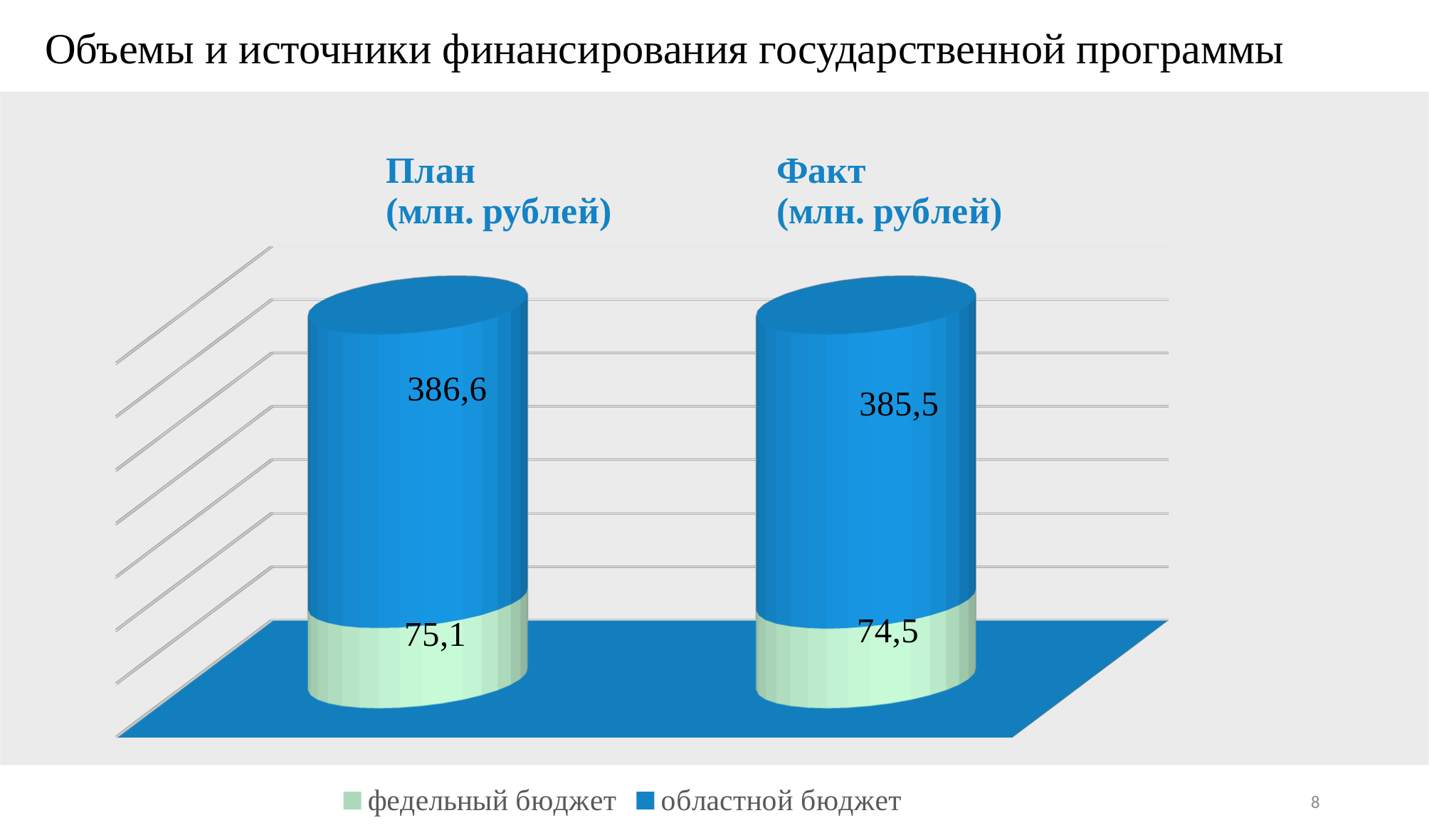
What is the total of the stacked bar for Факт? 460,0 How many series does the legend list? 2 What is the value of федельный бюджет for План? 75,1 Which is larger: областной бюджет for План or областной бюджет for Факт? План What is the total of the stacked bar for План? 461,7 What is the value of федельный бюджет for Факт? 74,5 How many categories are shown on the chart? 2 What is the difference between федельный бюджет for План and федельный бюджет for Факт? 0,6 What is the value of областной бюджет for План? 386,6 What is the difference between областной бюджет for План and областной бюджет for Факт? 1,1 What kind of chart is shown on the slide? Stacked bar chart What is the value of областной бюджет for Факт? 385,5